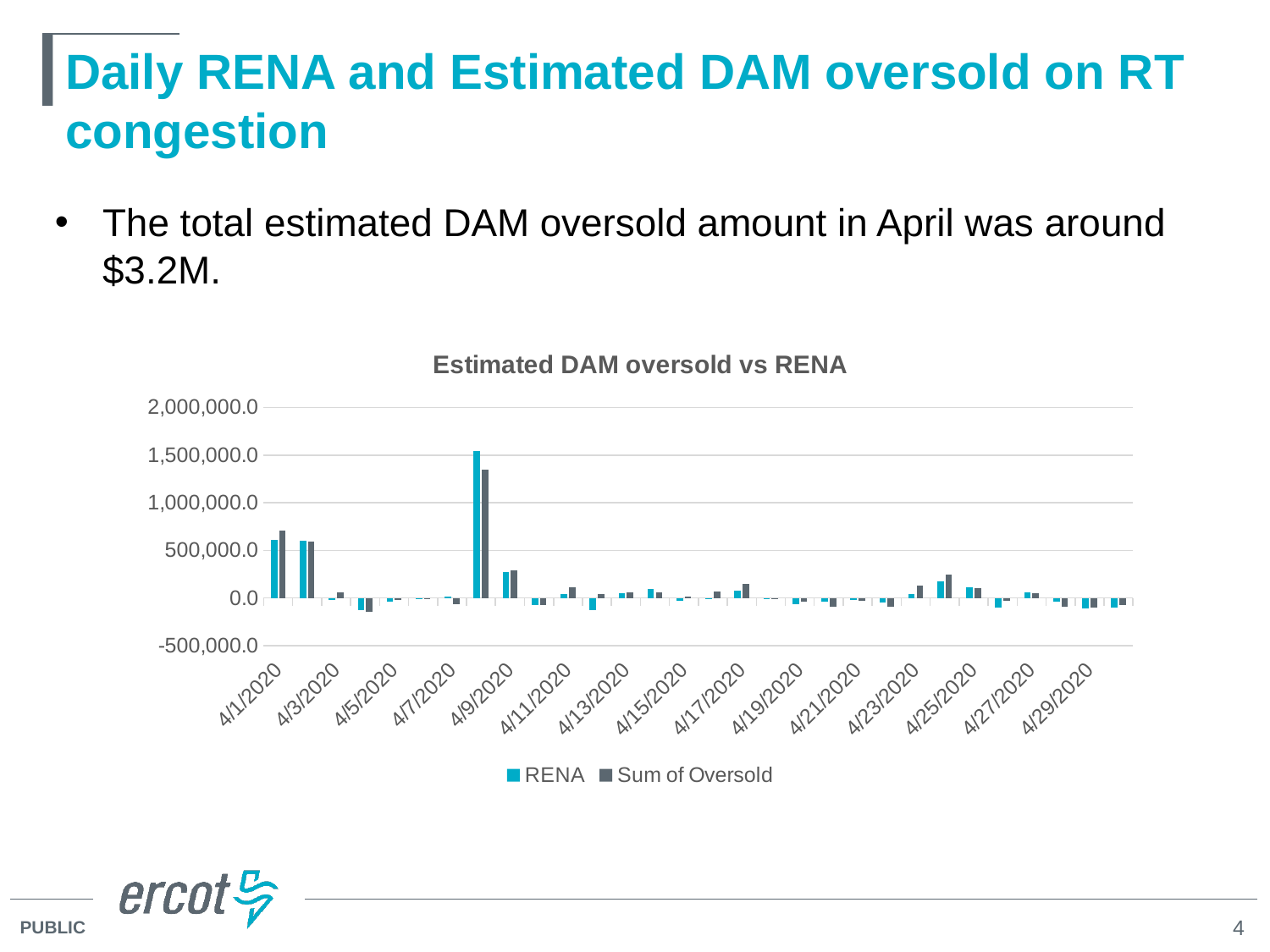
How many series does the legend list? 2 On which date is the Sum of Oversold value highest? 4/8/2020 Is the Sum of Oversold value for 4/9/2020 greater or less than 1,000,000.0? less What is the title of the chart? Estimated DAM oversold vs RENA What kind of chart is shown on the slide? Bar chart What are the two series named in the legend? RENA and Sum of Oversold Which is larger: the RENA value on 4/9/2020 or the RENA value on 4/1/2020? 4/1/2020 Is the RENA value for 4/9/2020 greater or less than 1,000,000.0? less Is the Sum of Oversold value for 4/1/2020 greater or less than 500,000.0? greater On which date is the RENA value highest? 4/8/2020